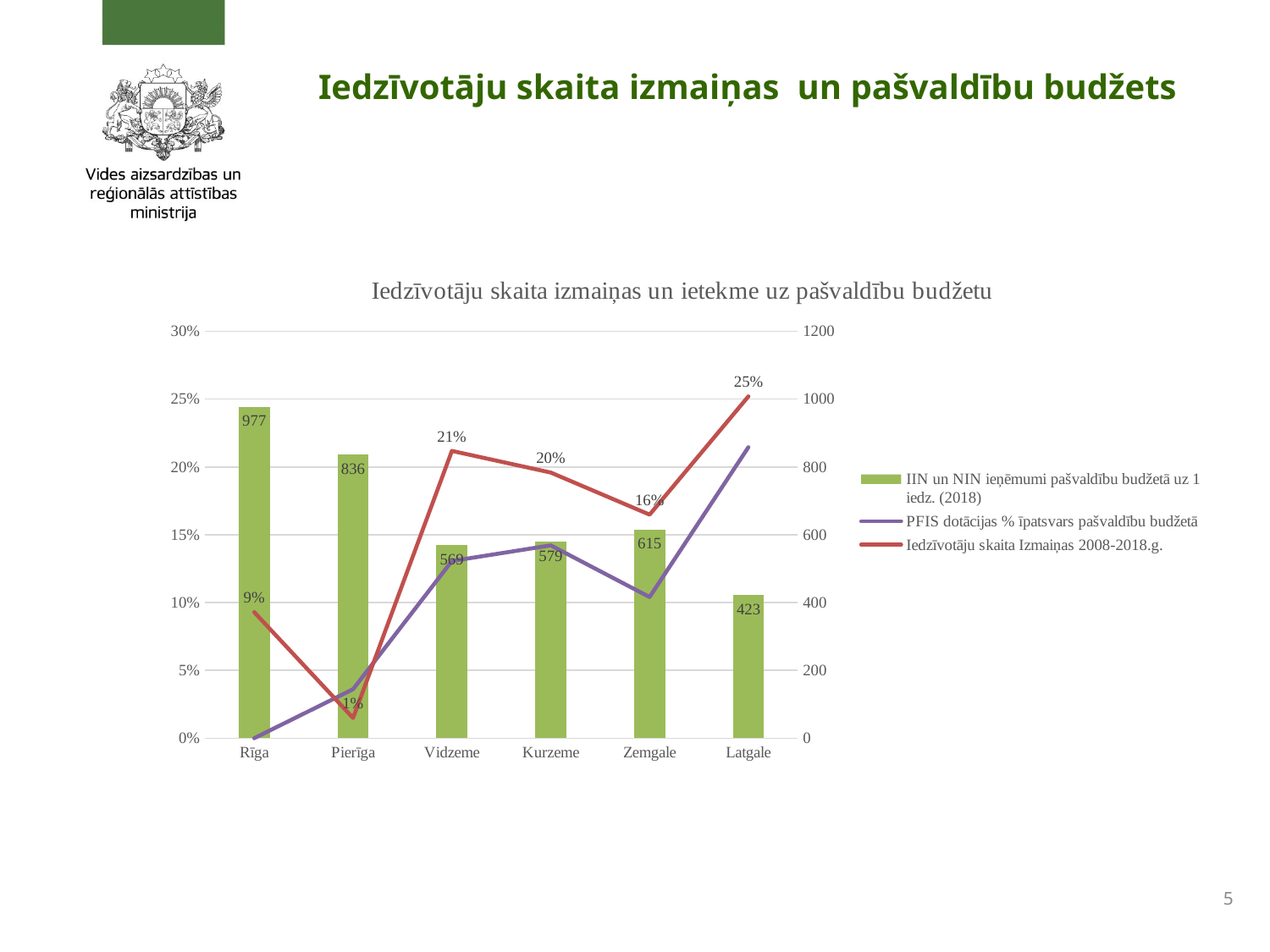
Which region has the lowest Iedzīvotāju skaita izmaiņas 2008-2018.g. value? Pierīga What is the Iedzīvotāju skaita izmaiņas 2008-2018.g. value for Vidzeme? 21% Which has a higher IIN un NIN ieņēmumi value, Zemgale or Kurzeme? Zemgale Is the PFIS dotācijas % īpatsvars pašvaldību budžetā value for Latgale greater or less than 20%? greater How many series does the legend list? 3 What is the value of IIN un NIN ieņēmumi pašvaldību budžetā uz 1 iedz. (2018) for Rīga? 977 What is the value of IIN un NIN ieņēmumi pašvaldību budžetā uz 1 iedz. (2018) for Latgale? 423 How many regions are shown on the x axis? 6 What is the difference between the IIN un NIN ieņēmumi values for Rīga and Pierīga? 141 Which series is drawn as a red line? Iedzīvotāju skaita Izmaiņas 2008-2018.g. Which region has the highest IIN un NIN ieņēmumi pašvaldību budžetā uz 1 iedz. (2018)? Rīga What is the title of the chart? Iedzīvotāju skaita izmaiņas un ietekme uz pašvaldību budžetu